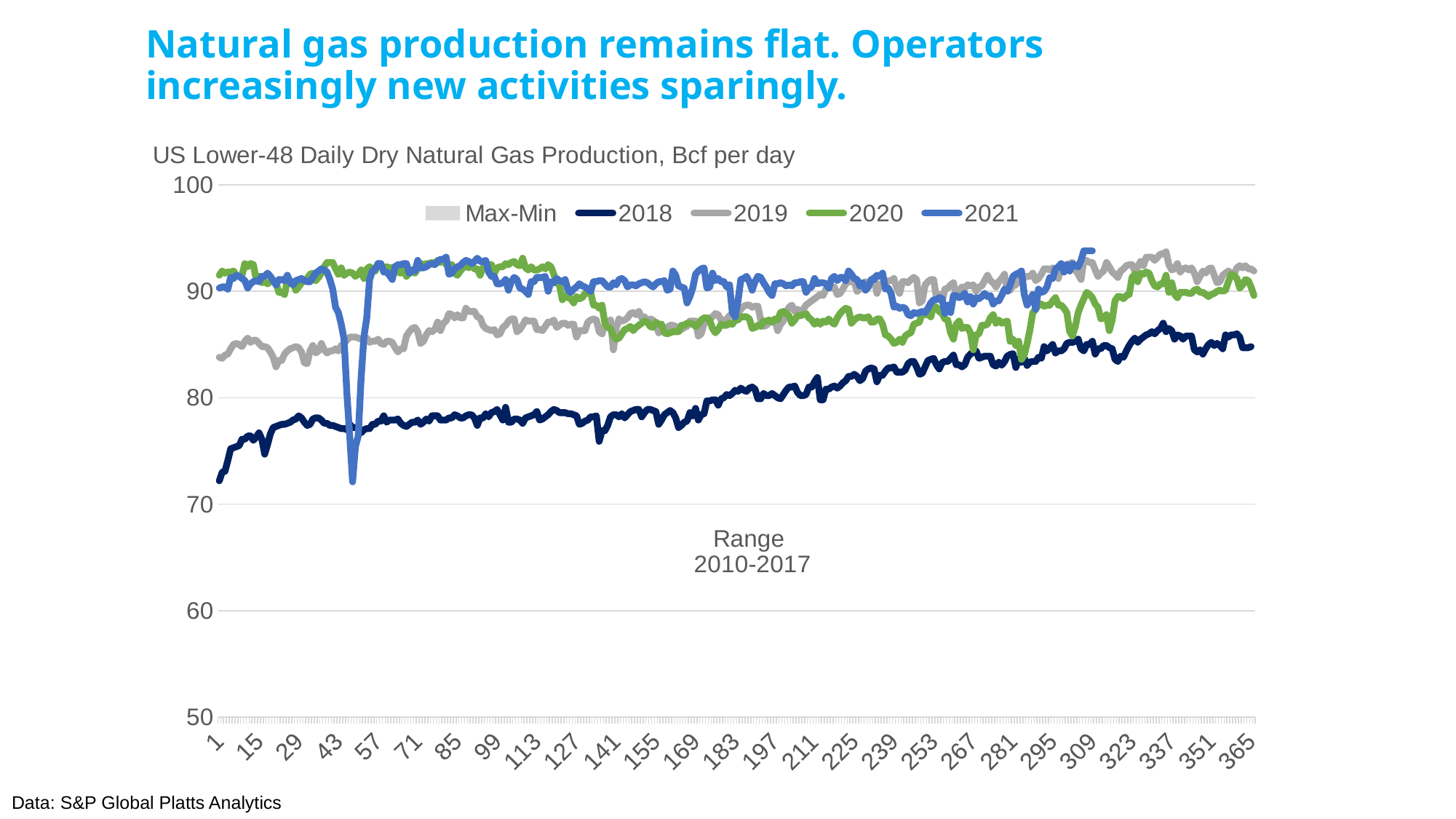
Which series has the lowest values across the whole year? 2018 At day 1, which is larger, the value for 2018 or the value for 2019? 2019 Is the value for 2019 at day 365 greater or less than 90? greater Is the value for 2018 at day 365 greater or less than 90? less Is the value for 2018 at day 1 greater or less than 80? less Which years are listed in the legend besides the Max-Min range? 2018, 2019, 2020, 2021 Does the 2018 line generally rise or fall from day 1 to day 365? rise Around day 141, which is larger, the value for 2021 or the value for 2020? 2021 What is the title of the chart? US Lower-48 Daily Dry Natural Gas Production, Bcf per day What kind of chart is shown on the slide? line chart How many series does the legend list? 5